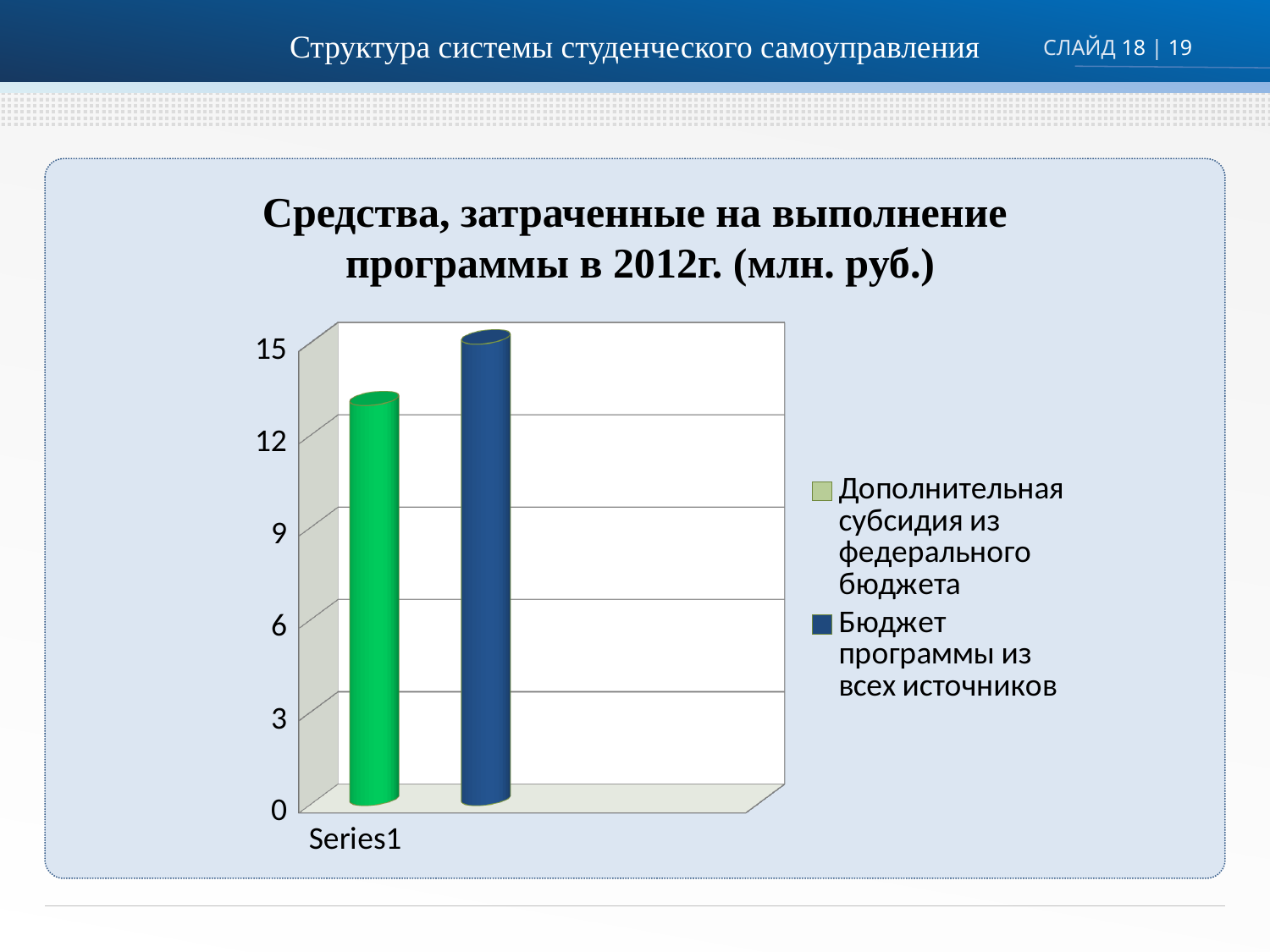
What kind of chart is shown on the slide? bar chart What is the title of the chart? Средства, затраченные на выполнение программы в 2012г. (млн. руб.) How many series does the legend list? 2 Is the value for Дополнительная субсидия из федерального бюджета greater or less than 15? less Which series has the highest value? Бюджет программы из всех источников How many categories are shown on the x axis? 1 Which series has the lowest value? Дополнительная субсидия из федерального бюджета Is the value for Бюджет программы из всех источников greater or less than 12? greater What is the label of the category on the x axis? Series1 What colour is the bar for Бюджет программы из всех источников? blue Which is larger: the value for Дополнительная субсидия из федерального бюджета or the value for Бюджет программы из всех источников? Бюджет программы из всех источников Is the value for Дополнительная субсидия из федерального бюджета greater or less than 12? greater